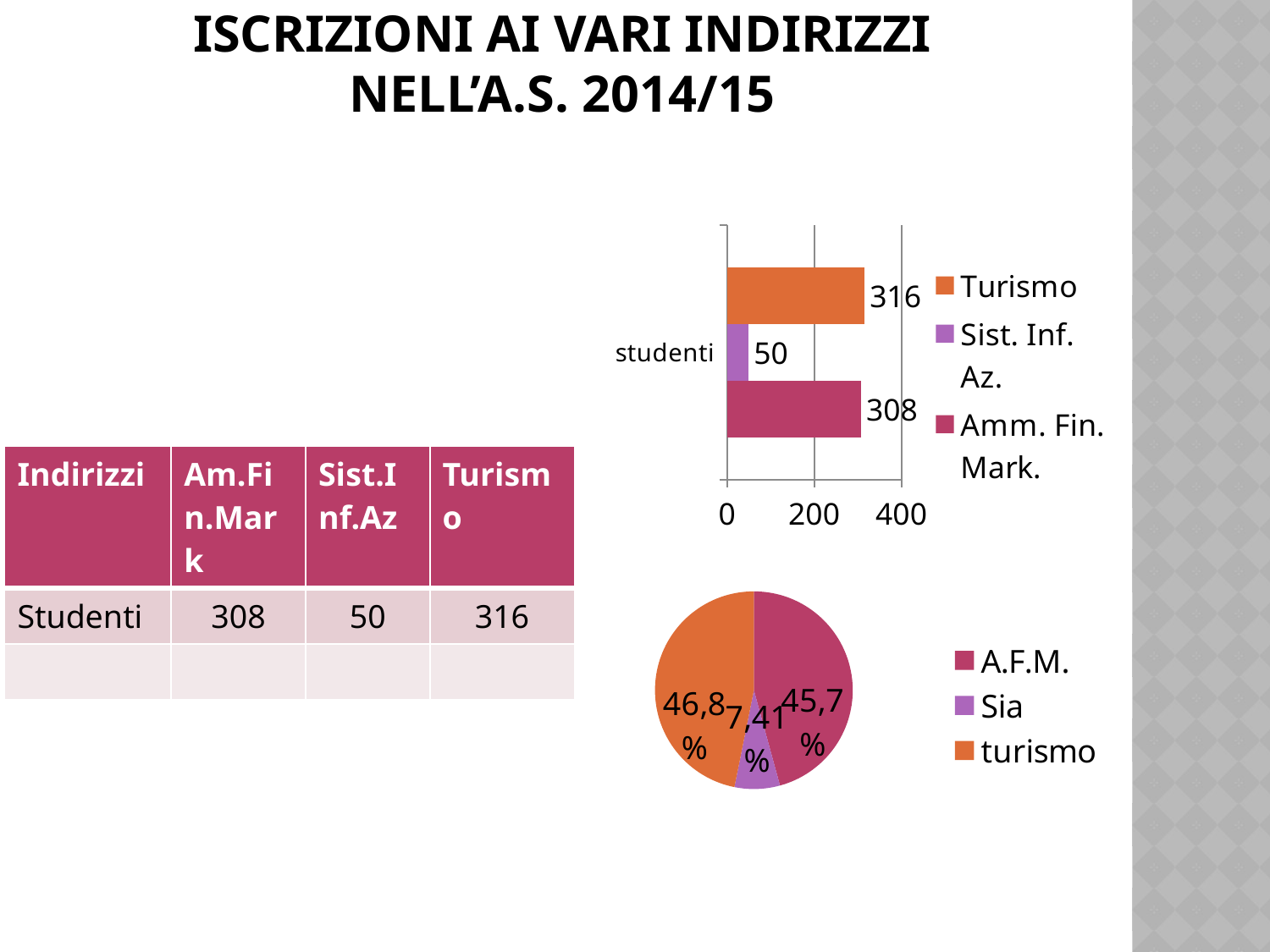
In the bar chart at the top right, which series has the lowest value? Sist. Inf. Az. In the pie chart at the bottom right, what share does the Sia slice have? 7,41% In the pie chart at the bottom right, which slice is the smallest? Sia In the pie chart at the bottom right, what share does the turismo slice have? 46,8% In the bar chart at the top right, what is the value for Turismo? 316 In the bar chart at the top right, what is the value for Sist. Inf. Az.? 50 In the pie chart at the bottom right, what share does the A.F.M. slice have? 45,7% What kind of chart is shown at the top right of the slide? bar chart In the bar chart at the top right, what is the difference between the Amm. Fin. Mark. and Sist. Inf. Az. values? 258 In the bar chart at the top right, how many series does the legend list? 3 In the bar chart at the top right, what is the difference between the Turismo and Amm. Fin. Mark. values? 8 In the bar chart at the top right, what is the value for Amm. Fin. Mark.? 308